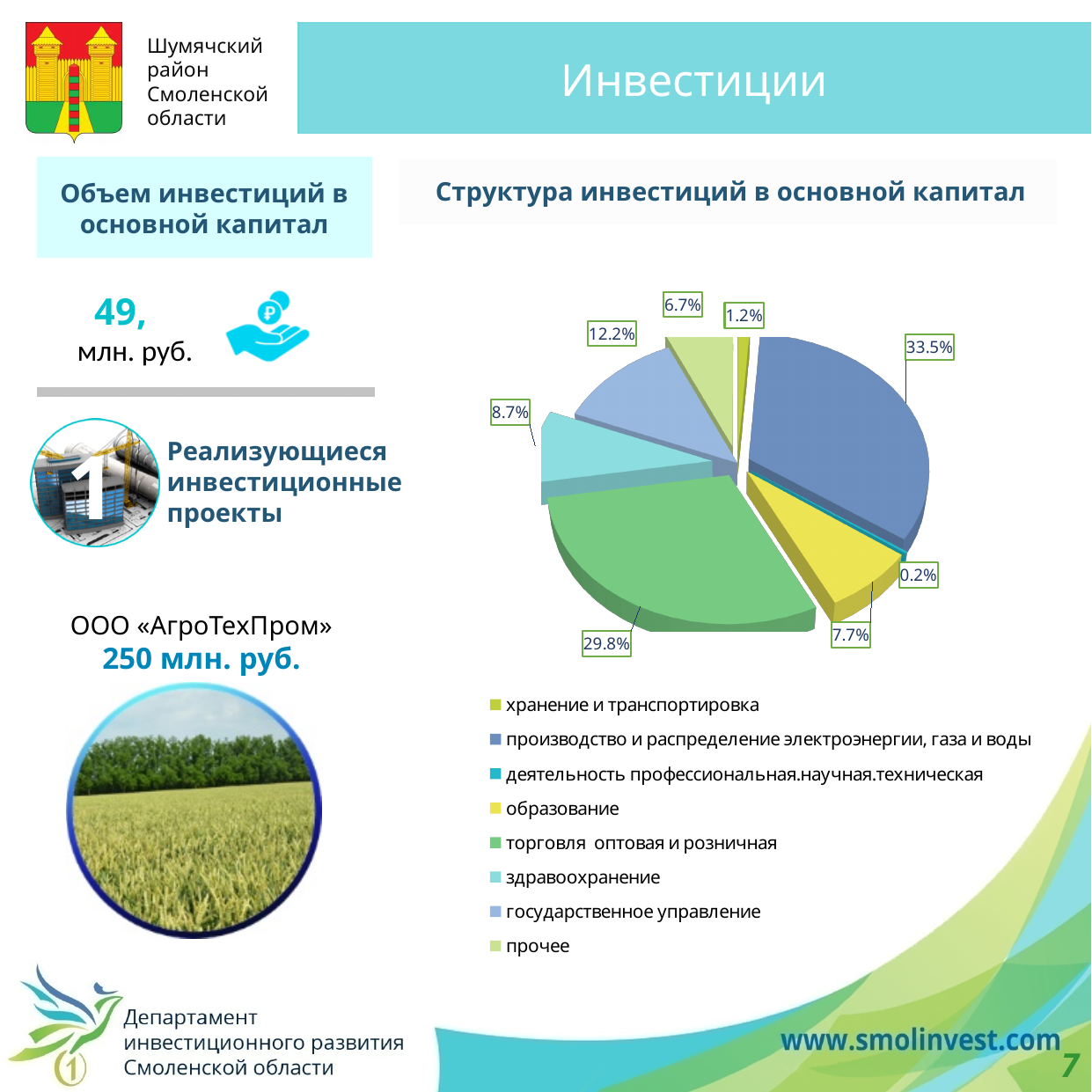
What is the difference in percentage points between the 'производство и распределение электроэнергии, газа и воды' slice and the 'торговля оптовая и розничная' slice? 3.7 What share is labelled for 'образование' in the pie chart? 7.7% Which category has the largest slice in the pie chart? производство и распределение электроэнергии, газа и воды What share of the pie chart 'Структура инвестиций в основной капитал' is 'торговля оптовая и розничная'? 29.8% What is the share of 'прочее' in the pie chart? 6.7% What percentage does 'здравоохранение' account for in the pie chart? 8.7% What is the share of 'государственное управление' in the pie chart? 12.2% What type of chart is used to show 'Структура инвестиций в основной капитал'? pie chart Which category has the smallest slice in the pie chart? деятельность профессиональная.научная.техническая In the pie chart, what percentage is shown for 'производство и распределение электроэнергии, газа и воды'? 33.5% How many categories does the legend of the pie chart list? 8 Which is larger in the pie chart: 'здравоохранение' or 'образование'? здравоохранение